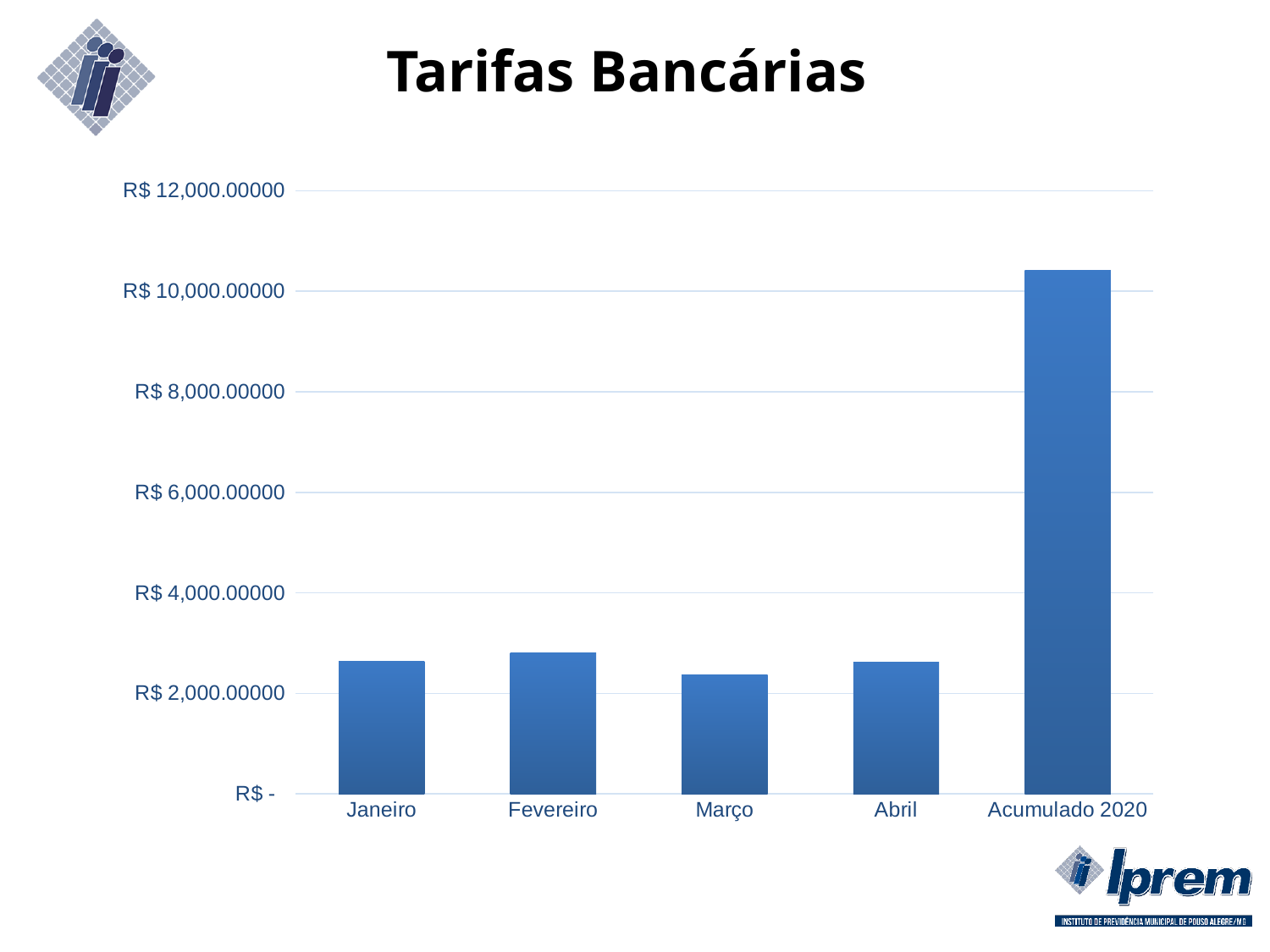
Which is larger, the value for Acumulado 2020 or the value for Abril? Acumulado 2020 Is the value for Acumulado 2020 greater or less than R$ 12,000.00000? less Is the value for Janeiro greater or less than R$ 2,000.00000? greater Is the value for Acumulado 2020 greater or less than R$ 10,000.00000? greater How many categories are shown on the x axis? 5 What is the title of the chart? Tarifas Bancárias Which month has the lowest value? Março What kind of chart is shown on the slide? bar chart Which is larger, the value for Fevereiro or the value for Março? Fevereiro Which category has the highest value? Acumulado 2020